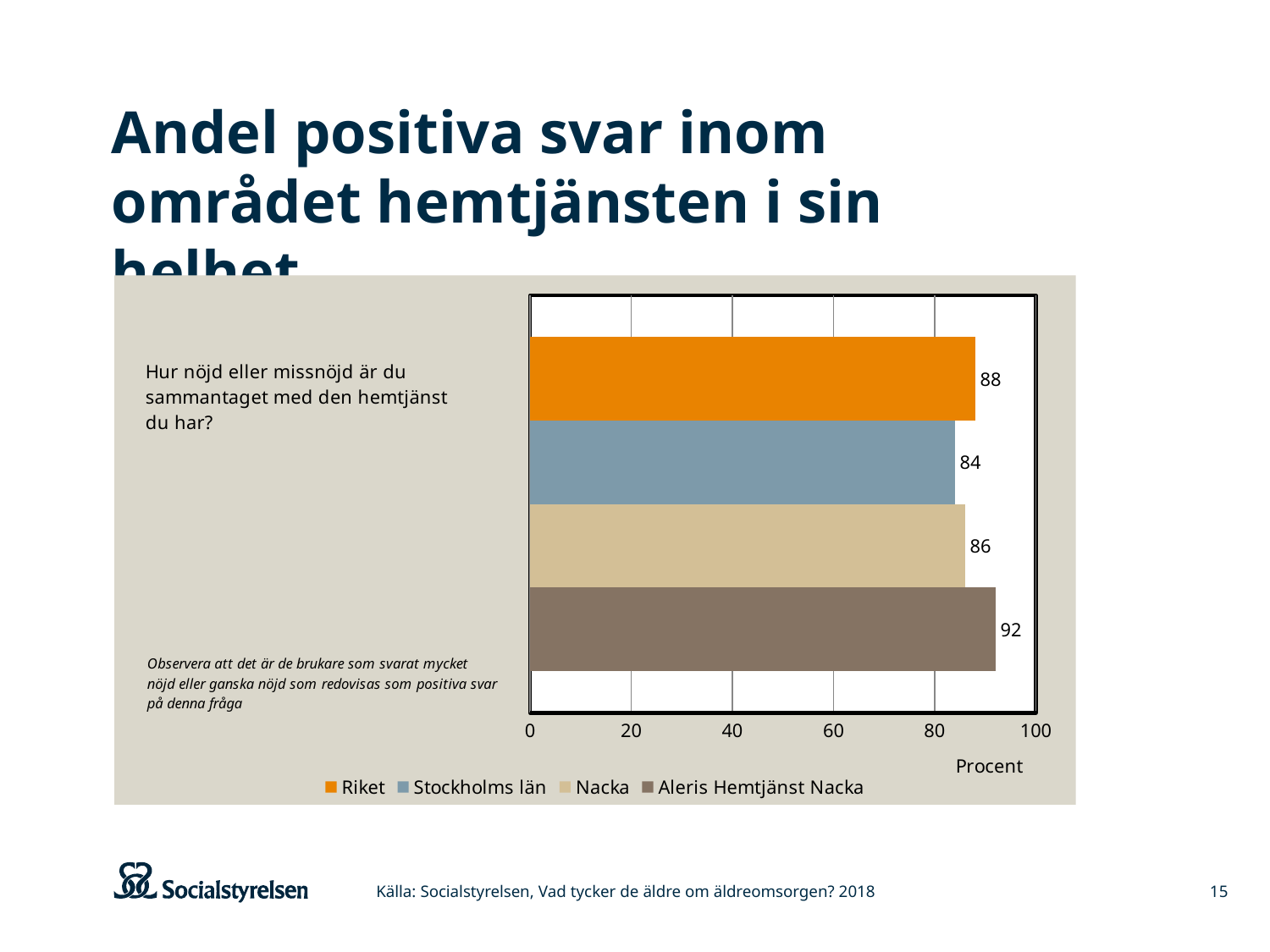
What is the difference between the values for Aleris Hemtjänst Nacka and Riket? 4 Which is larger, the value for Nacka or the value for Stockholms län? Nacka What is the value for Nacka? 86 Which series has the lowest value? Stockholms län What is the label on the horizontal axis of the chart? Procent What is the value for Aleris Hemtjänst Nacka? 92 Which series has the highest value? Aleris Hemtjänst Nacka What is the value for Stockholms län? 84 What is the difference between the values for Riket and Stockholms län? 4 What is the value for Riket? 88 What kind of chart is shown on the slide? bar chart How many series does the legend list? 4